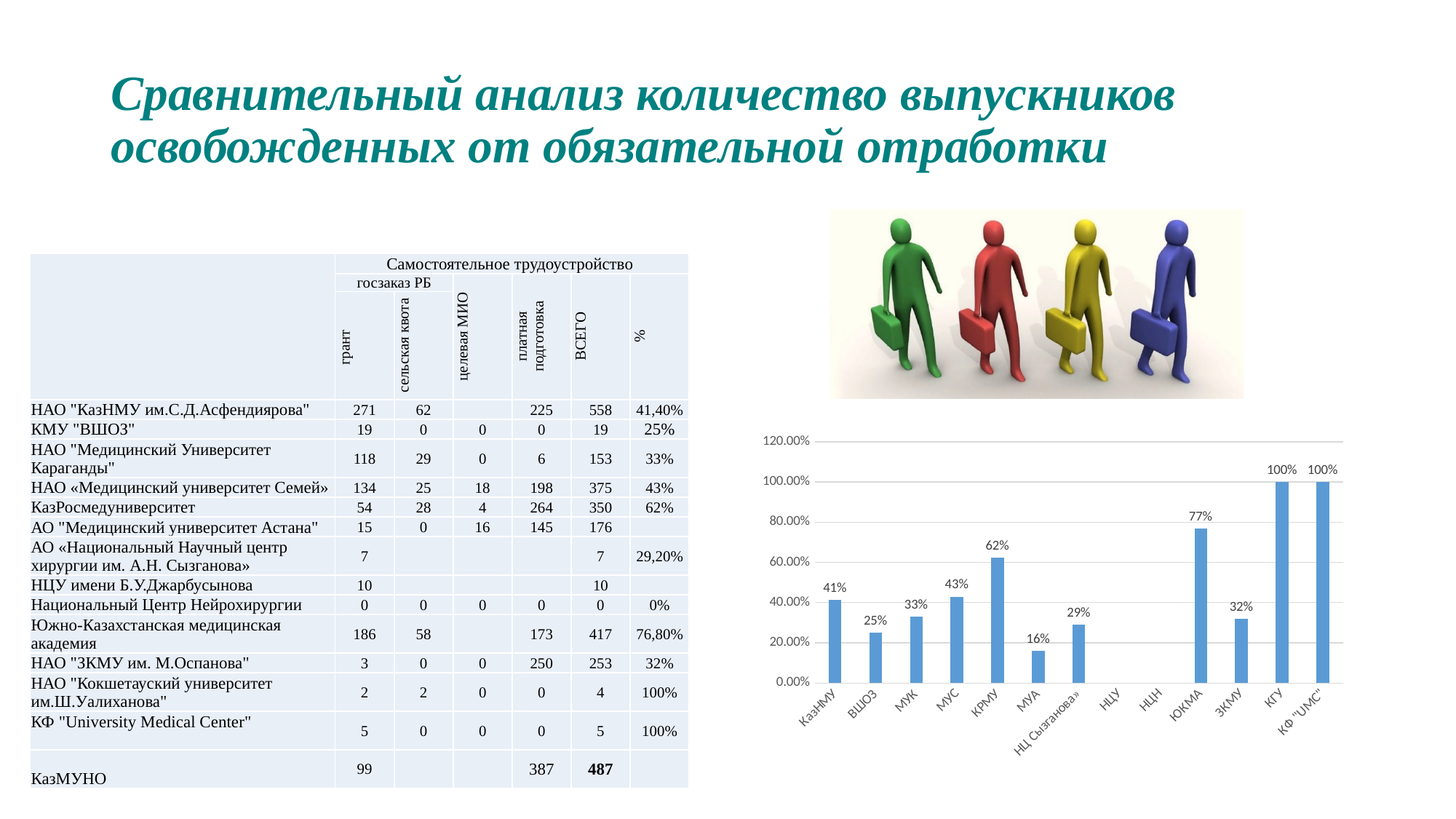
What type of chart is shown on the slide? bar chart What is the highest tick value shown on the y axis of the chart? 120.00% What is the difference between the values for КРМУ and ВШОЗ in the chart? 37% What is the value shown for ЮКМА in the bar chart? 77% How many category labels are shown on the x axis of the chart? 13 What is the value shown for МУА in the bar chart? 16% Which category has the lowest non-zero bar in the chart? МУА What is the value shown for КазНМУ in the bar chart? 41% What is the value shown for КРМУ in the bar chart? 62% Which is larger in the chart, the value for МУС or the value for МУК? МУС What is the difference between the values for ЮКМА and ЗКМУ in the chart? 45% Which two categories share the highest value of 100% in the chart? КГУ and КФ "UMC"